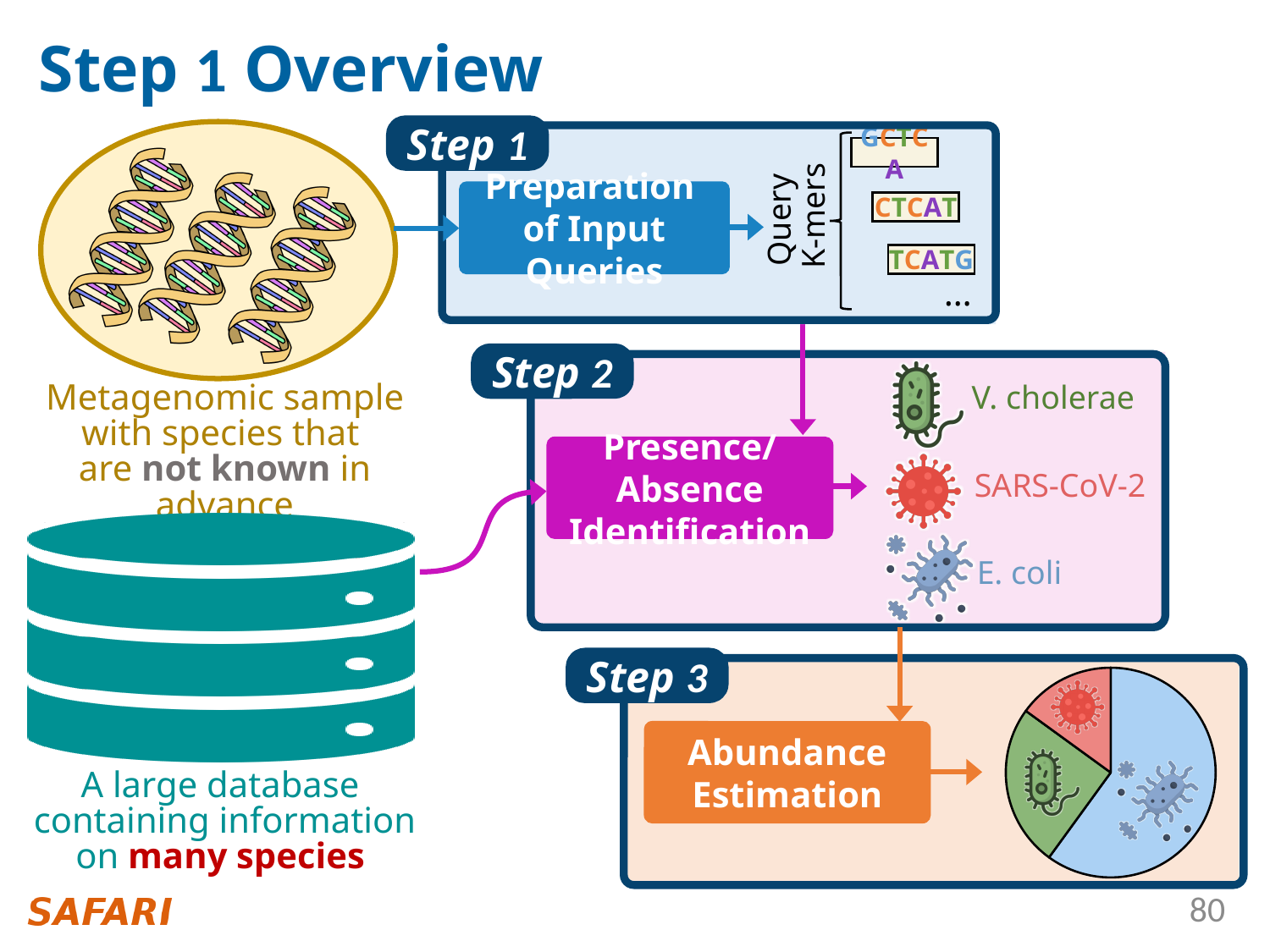
Which process box feeds its output into the pie chart in the Step 3 box? Abundance Estimation Which colour slice is the smallest in the pie chart in the Step 3 box? red Which species icon appears in the largest slice of the pie chart in the Step 3 box? E. coli In the pie chart in the Step 3 box, is the blue slice more or less than half of the pie? more Which colour slice is the largest in the pie chart in the Step 3 box? blue What kind of chart is shown in the Step 3 box? pie chart In the pie chart in the Step 3 box, is the blue slice or the green slice larger? blue How many slices does the pie chart in the Step 3 box have? 3